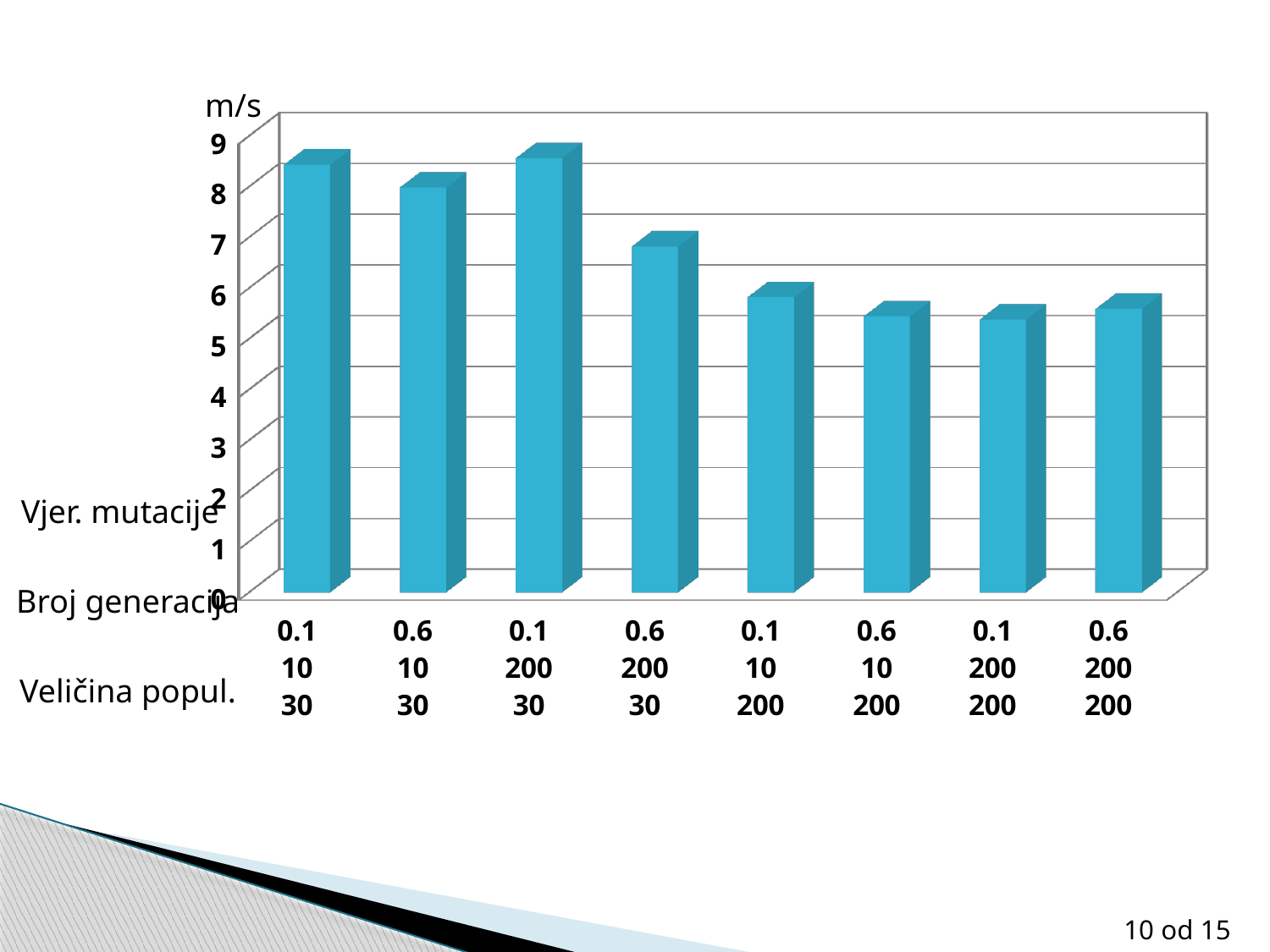
What unit is shown at the top of the vertical axis? m/s Is the value for the bar labelled 0.1 / 10 / 200 greater or less than 5? greater How many bars are plotted in the chart? 8 Is the value for the bar labelled 0.6 / 200 / 30 greater or less than 6? greater Is the value for the bar labelled 0.1 / 10 / 30 (Vjer. mutacije / Broj generacija / Veličina popul.) greater or less than 7? greater What are the three row labels of the category axis (Vjer. mutacije, Broj generacija, and which third one)? Veličina popul. Which bar is taller: 0.1 / 10 / 30 or 0.6 / 200 / 30? 0.1 / 10 / 30 What kind of chart is shown on the slide? bar chart Do the bar values generally rise or fall from left to right across the chart? fall Which bar is taller: 0.1 / 200 / 30 or 0.1 / 10 / 200? 0.1 / 200 / 30